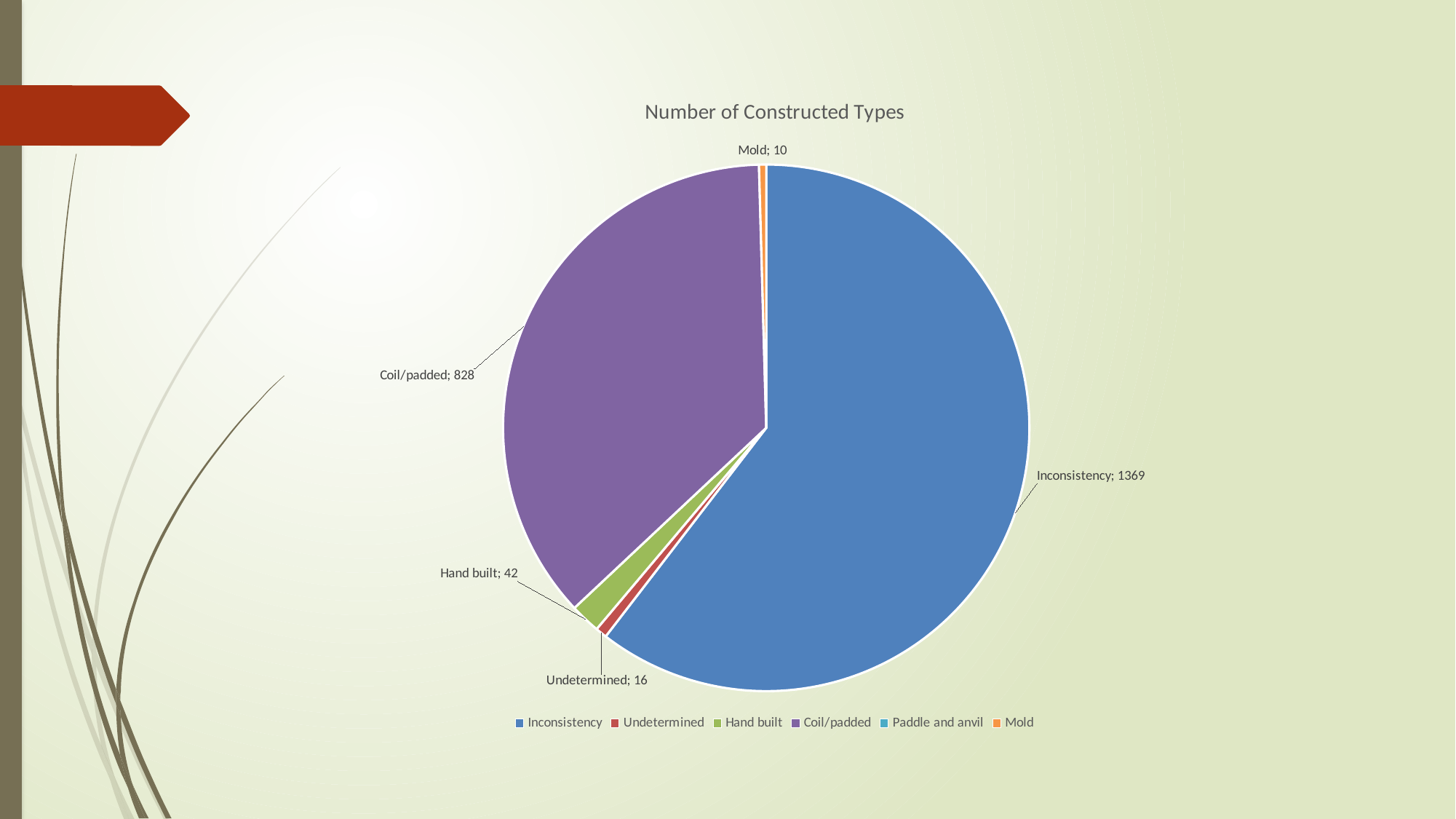
What kind of chart is shown on the slide? Pie chart What is the value for Undetermined? 16 How many entries does the legend list? 6 Which is larger, the value for Hand built or the value for Mold? Hand built What is the value for Hand built? 42 What is the difference between the values for Inconsistency and Coil/padded? 541 What is the value for Inconsistency? 1369 Which category has the largest slice of the pie? Inconsistency What is the value for Mold? 10 What is the value for Coil/padded? 828 What is the difference between the values for Hand built and Undetermined? 26 What is the title of the chart? Number of Constructed Types